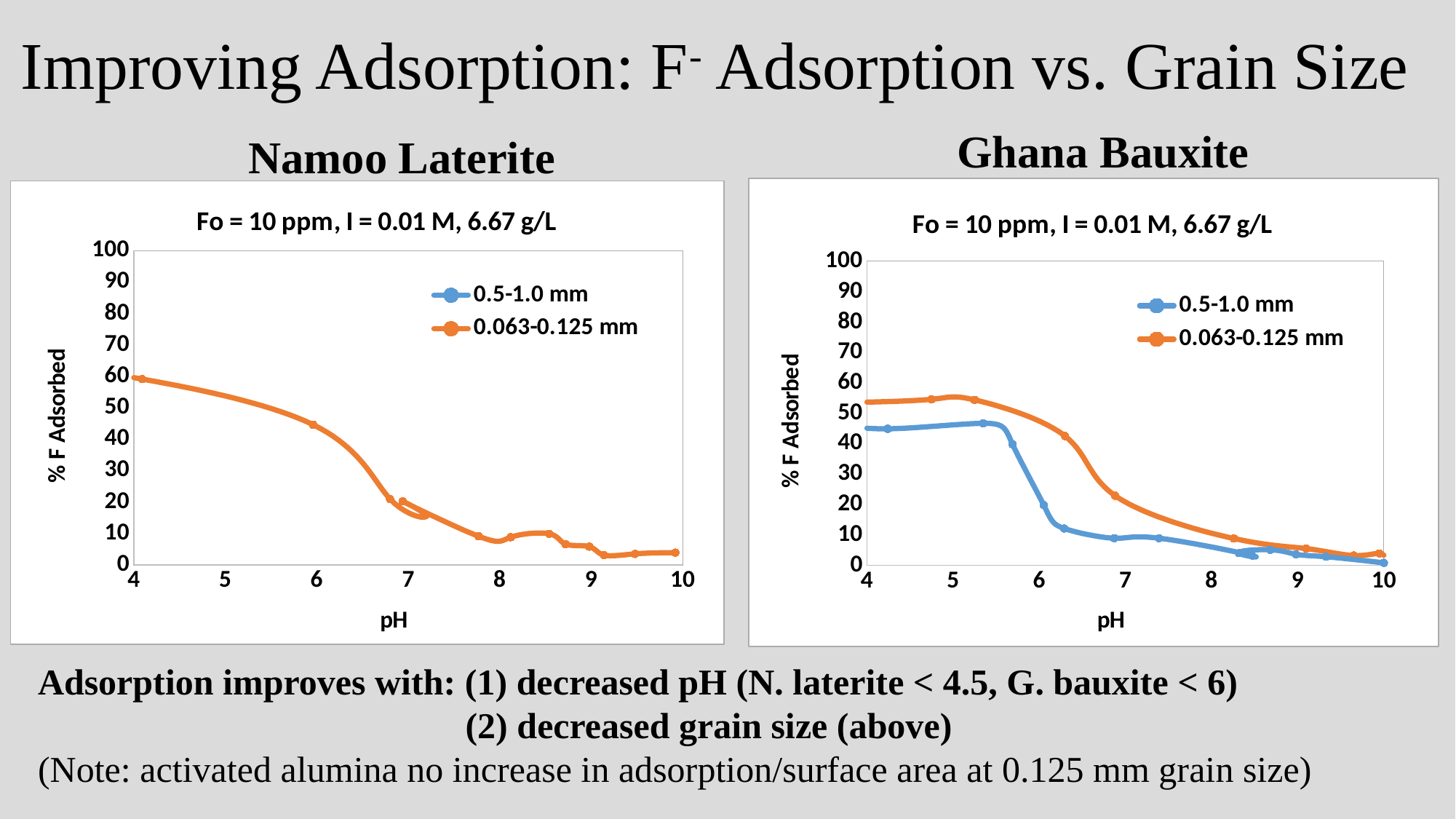
What is the label of the y axis on the Namoo Laterite chart? % F Adsorbed In the Ghana Bauxite chart, which series has the larger value at pH 6, 0.5-1.0 mm or 0.063-0.125 mm? 0.063-0.125 mm In the Namoo Laterite chart, does % F Adsorbed rise or fall as pH increases from 4 to 10? fall In the Ghana Bauxite chart, is the value for the 0.5-1.0 mm series at pH 4 greater or less than 50? less What kind of chart is the Ghana Bauxite chart? line chart In the Namoo Laterite chart, is the value for the 0.063-0.125 mm series at pH 4 greater or less than 50? greater What kind of chart is the Namoo Laterite chart? line chart In the Ghana Bauxite chart, does % F Adsorbed rise or fall as pH increases from 6 to 10? fall In the Ghana Bauxite chart, is the value for the 0.063-0.125 mm series at pH 4 greater or less than 50? greater How many series does the legend of the Ghana Bauxite chart list? 2 How many series does the legend of the Namoo Laterite chart list? 2